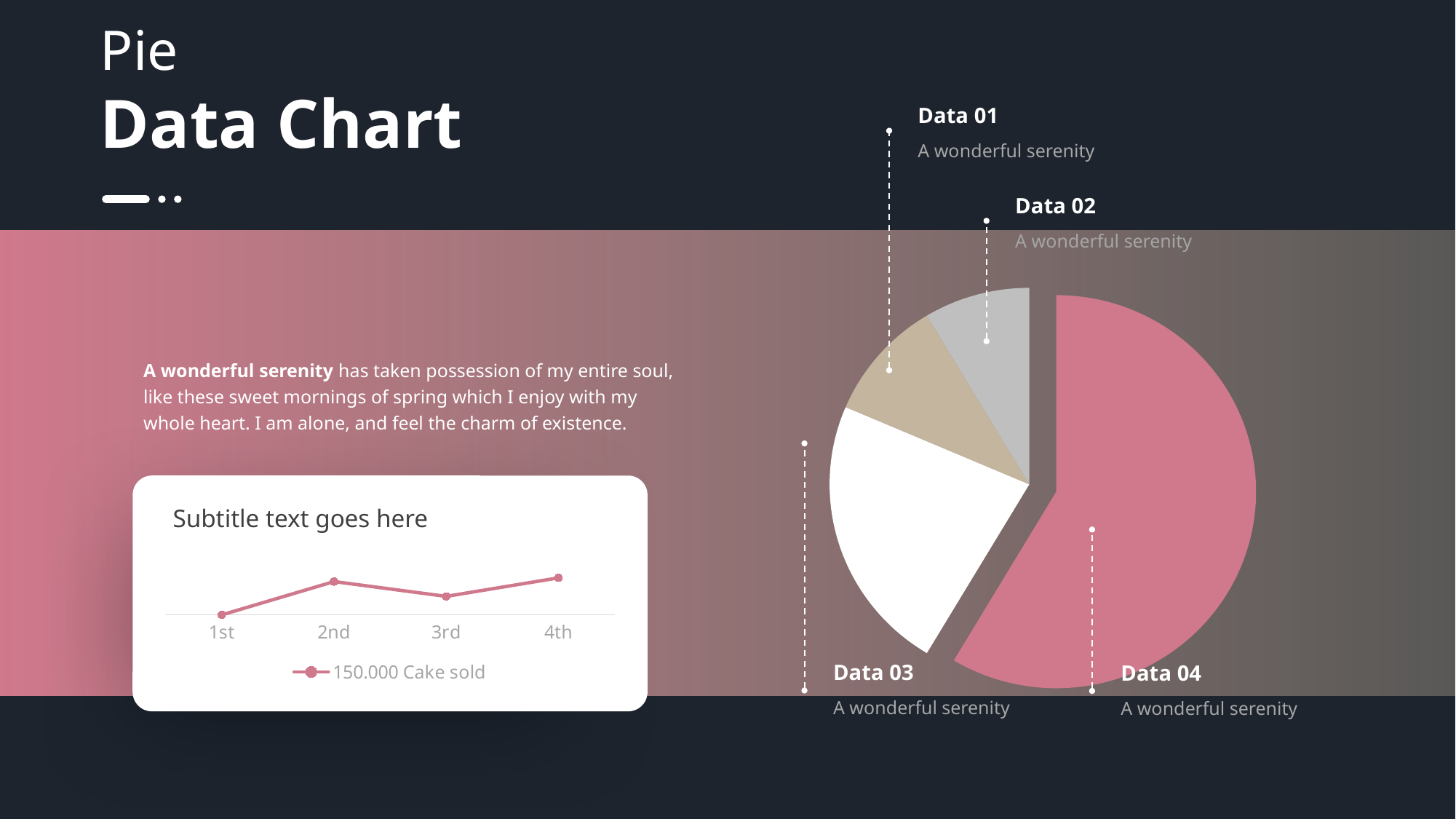
In the line chart in the white card, what is the legend entry for the series? 150.000 Cake sold In the pie chart on the right, which slice is larger, Data 01 or Data 02? Data 01 In the pie chart on the right, which slice is larger, Data 01 or Data 03? Data 03 In the pie chart on the right, how many slices are there? 4 In the line chart in the white card, how many points are plotted along the x axis? 4 In the pie chart on the right, what colour is the Data 04 slice? pink In the line chart in the white card, does the line rise or fall from 1st to 2nd? rise What kind of chart is shown in the white card on the left of the slide? line chart In the line chart in the white card, how many series does the legend list? 1 In the pie chart on the right, which data label corresponds to the largest slice? Data 04 In the pie chart on the right, which data label corresponds to the smallest slice? Data 02 What kind of chart is the large chart on the right of the slide? pie chart